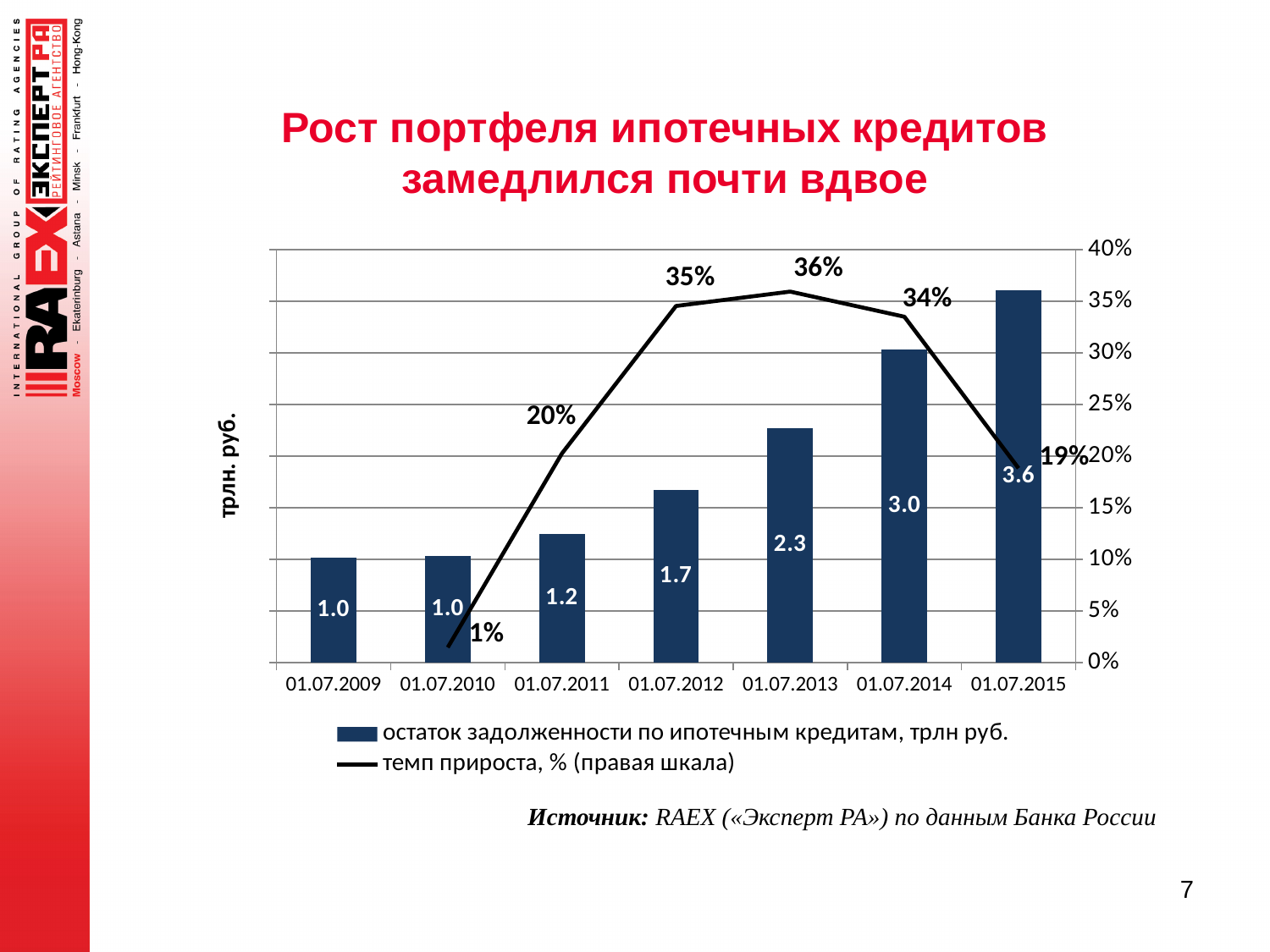
Which date has the highest mortgage debt balance? 01.07.2015 Does the mortgage debt balance rise or fall from 01.07.2009 to 01.07.2015? rise What is the label of the left vertical axis? трлн. руб. What is the difference between the growth rate for 01.07.2014 and 01.07.2015? 15% What is the value of the mortgage debt balance (остаток задолженности) for 01.07.2015? 3.6 What is the growth rate (темп прироста) shown for 01.07.2013? 36% Which date has the highest growth rate on the line? 01.07.2013 What is the growth rate (темп прироста) shown for 01.07.2010? 1% How many dates are shown on the x axis? 7 Which is larger: the mortgage debt balance for 01.07.2012 or for 01.07.2013? 01.07.2013 What is the difference between the mortgage debt balance for 01.07.2015 and 01.07.2014? 0.6 How many series does the legend list? 2